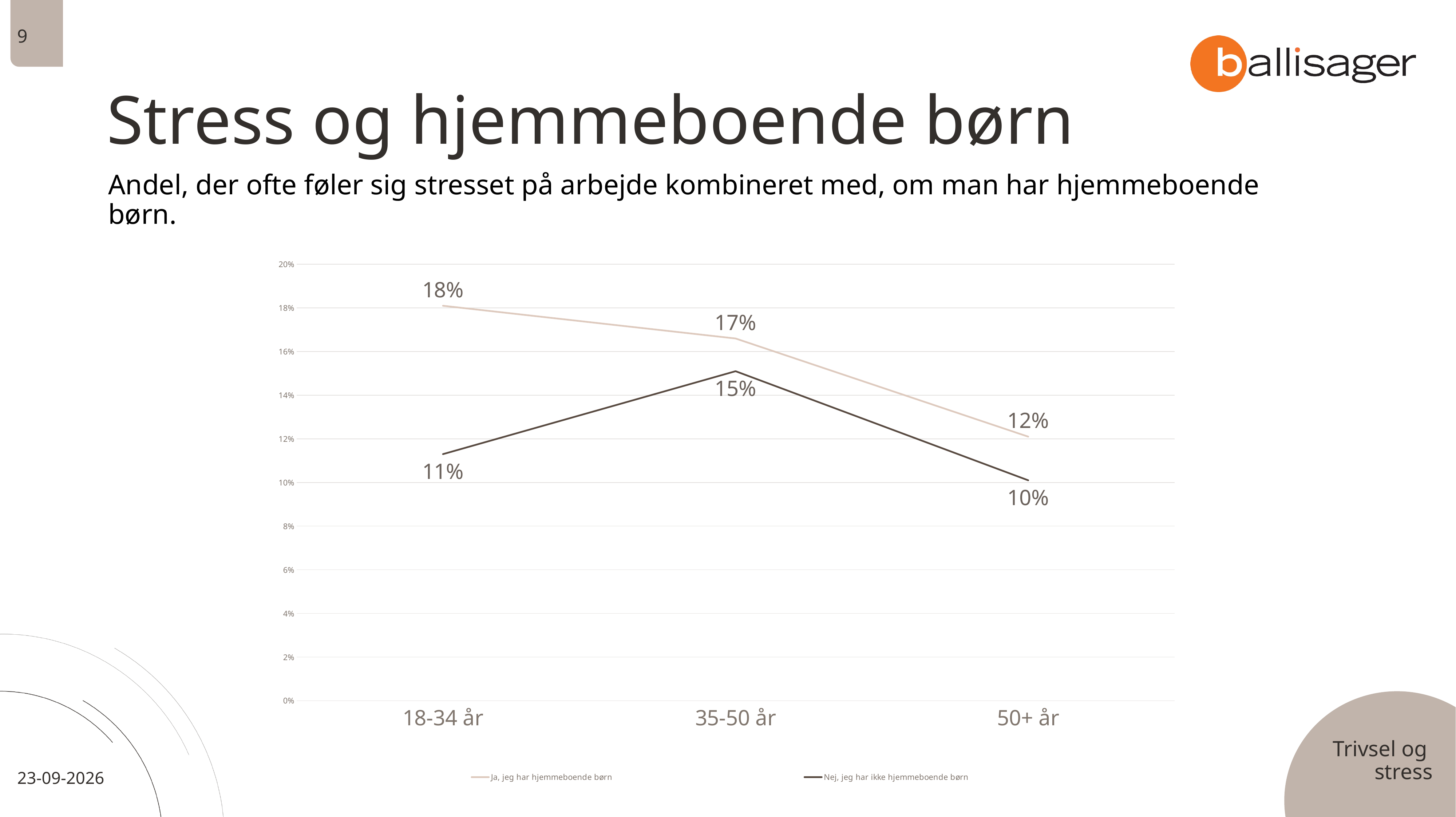
Which age group has the lowest value for 'Nej, jeg har ikke hjemmeboende børn'? 50+ år Which age group has the highest value for 'Ja, jeg har hjemmeboende børn'? 18-34 år In the 35-50 år group, which series has the larger value? Ja, jeg har hjemmeboende børn What is the difference between the two series in the 18-34 år group? 7 percentage points What is the value for 'Ja, jeg har hjemmeboende børn' in the 18-34 år group? 18% What kind of chart is shown on the slide? Line chart Does the 'Ja, jeg har hjemmeboende børn' series rise or fall from 18-34 år to 50+ år? Fall How many age groups are shown on the x axis? 3 What is the value for 'Ja, jeg har hjemmeboende børn' in the 50+ år group? 12% What is the value for 'Nej, jeg har ikke hjemmeboende børn' in the 35-50 år group? 15% How many series does the legend list? 2 What is the value for 'Nej, jeg har ikke hjemmeboende børn' in the 50+ år group? 10%